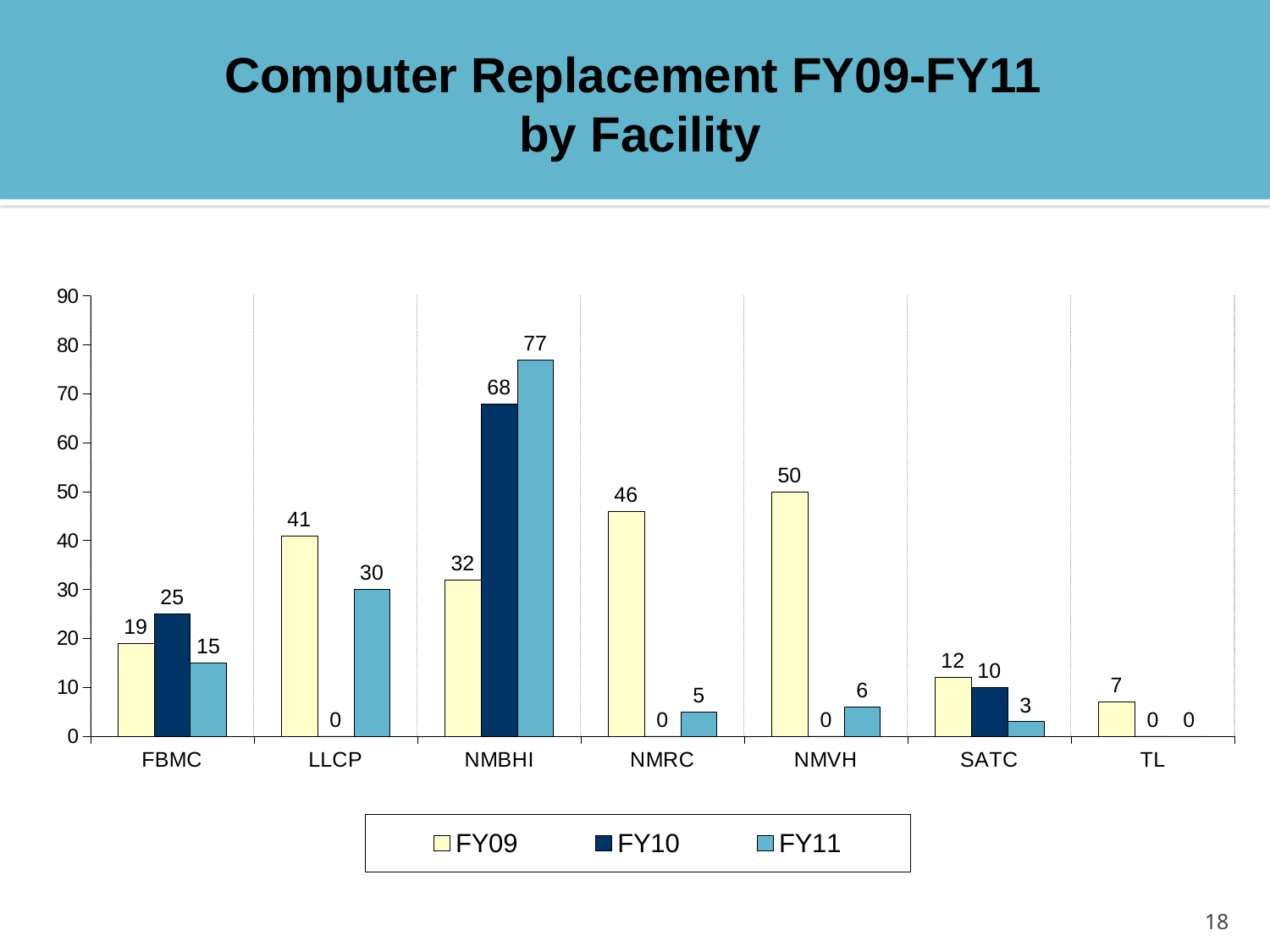
What kind of chart is shown on the slide? Bar chart How many facilities are shown on the x axis? 7 What is the FY10 value for SATC? 10 What is the title of the chart? Computer Replacement FY09-FY11 by Facility Which is larger, the FY09 value for LLCP or the FY09 value for NMRC? NMRC What is the difference between the FY11 and FY10 values for NMBHI? 9 What is the FY11 value for NMBHI? 77 What is the FY09 value for NMVH? 50 How many series does the legend list? 3 Which facility has the lowest FY09 value? TL Which facility has the highest FY09 value? NMVH What is the difference between the FY10 and FY09 values for FBMC? 6